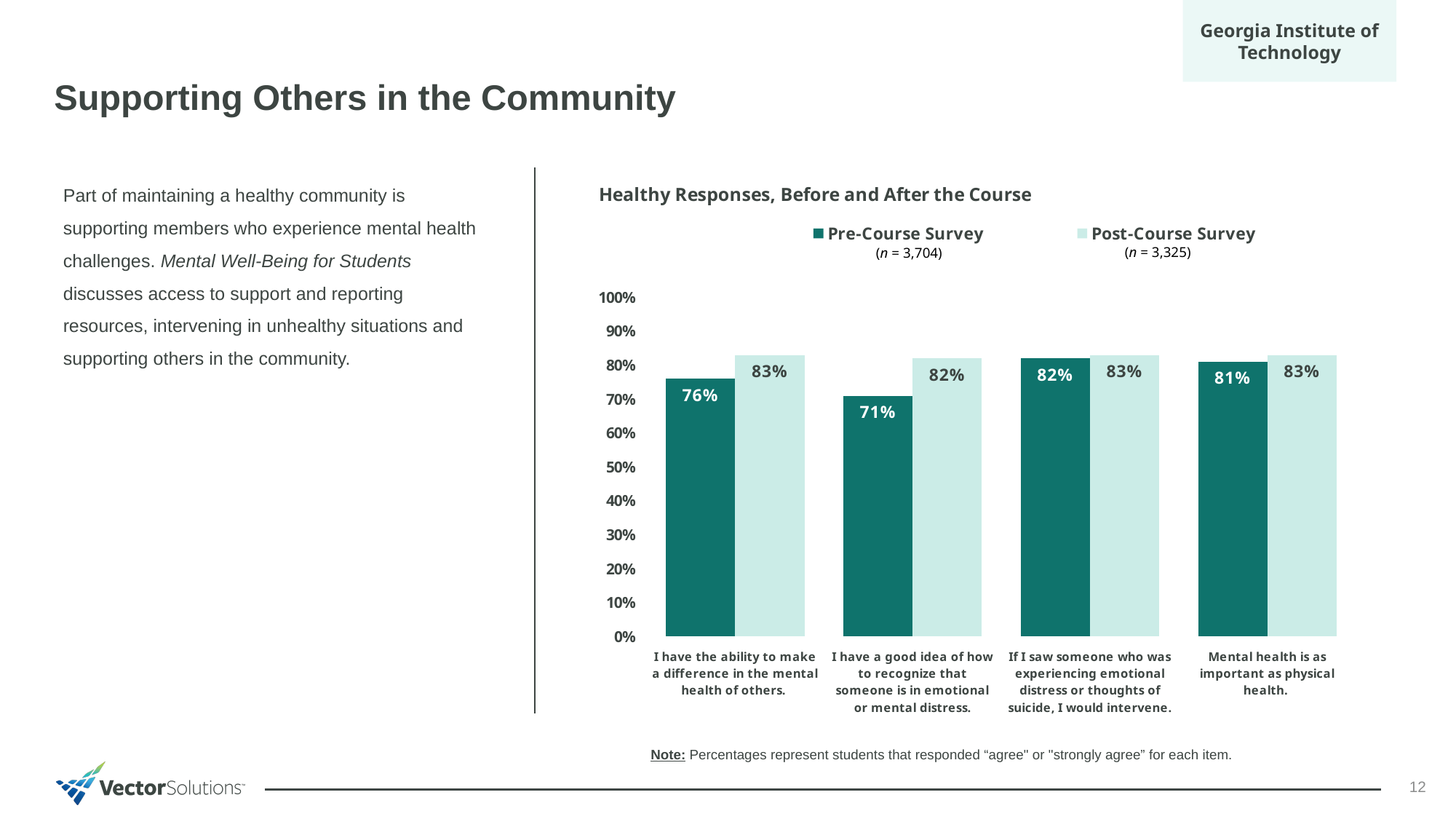
What kind of chart is shown on the slide? Bar chart Is the Pre-Course Survey value for "I have a good idea of how to recognize that someone is in emotional or mental distress." greater or less than 80%? less Which category has the highest Pre-Course Survey value? If I saw someone who was experiencing emotional distress or thoughts of suicide, I would intervene. What is the Pre-Course Survey value for "I have the ability to make a difference in the mental health of others."? 76% What is the sample size (n) for the Post-Course Survey shown in the legend? 3,325 How many categories are shown on the x axis of the chart? 4 Which category has the lowest Pre-Course Survey value? I have a good idea of how to recognize that someone is in emotional or mental distress. What is the Pre-Course Survey value for "Mental health is as important as physical health."? 81% How many series does the chart legend list? 2 What is the Post-Course Survey value for "I have a good idea of how to recognize that someone is in emotional or mental distress."? 82% Which is larger for "I have the ability to make a difference in the mental health of others.": the Pre-Course Survey value or the Post-Course Survey value? Post-Course Survey What is the difference between the Post-Course and Pre-Course Survey values for "I have a good idea of how to recognize that someone is in emotional or mental distress."? 11%